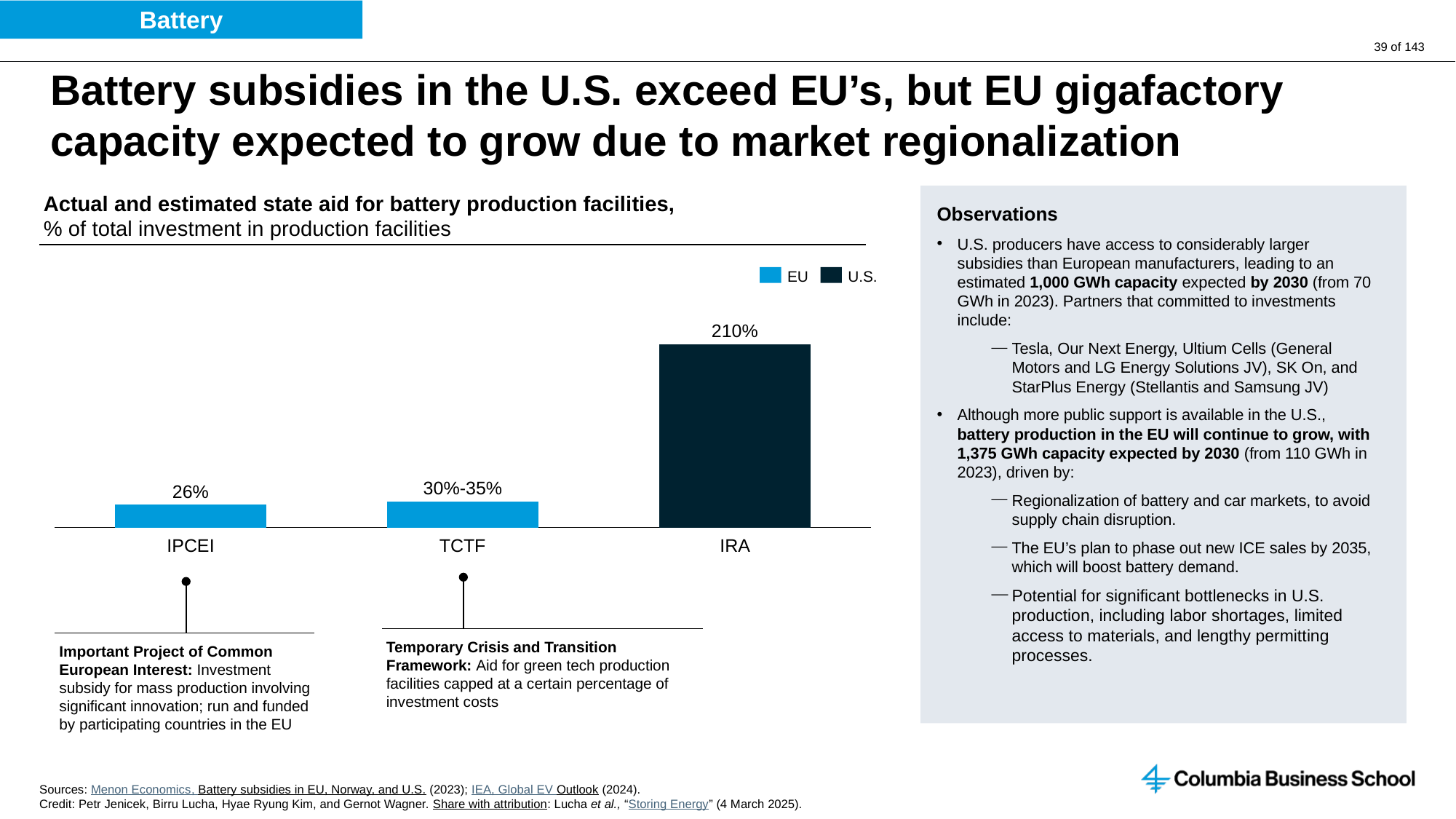
What is the value shown for IPCEI? 26% What is the title of the chart? Actual and estimated state aid for battery production facilities, % of total investment in production facilities How many categories are shown on the x axis? 3 Which series does the IRA bar belong to, according to the legend? U.S. Which is larger, the value for IRA or the value for TCTF? IRA How many series does the legend list? 2 Which category has the lowest value? IPCEI What kind of chart is shown? Bar chart What is the value shown for IRA? 210% What is the difference between the IRA value and the IPCEI value? 184% Which category has the highest value? IRA What is the value shown for TCTF? 30%-35%